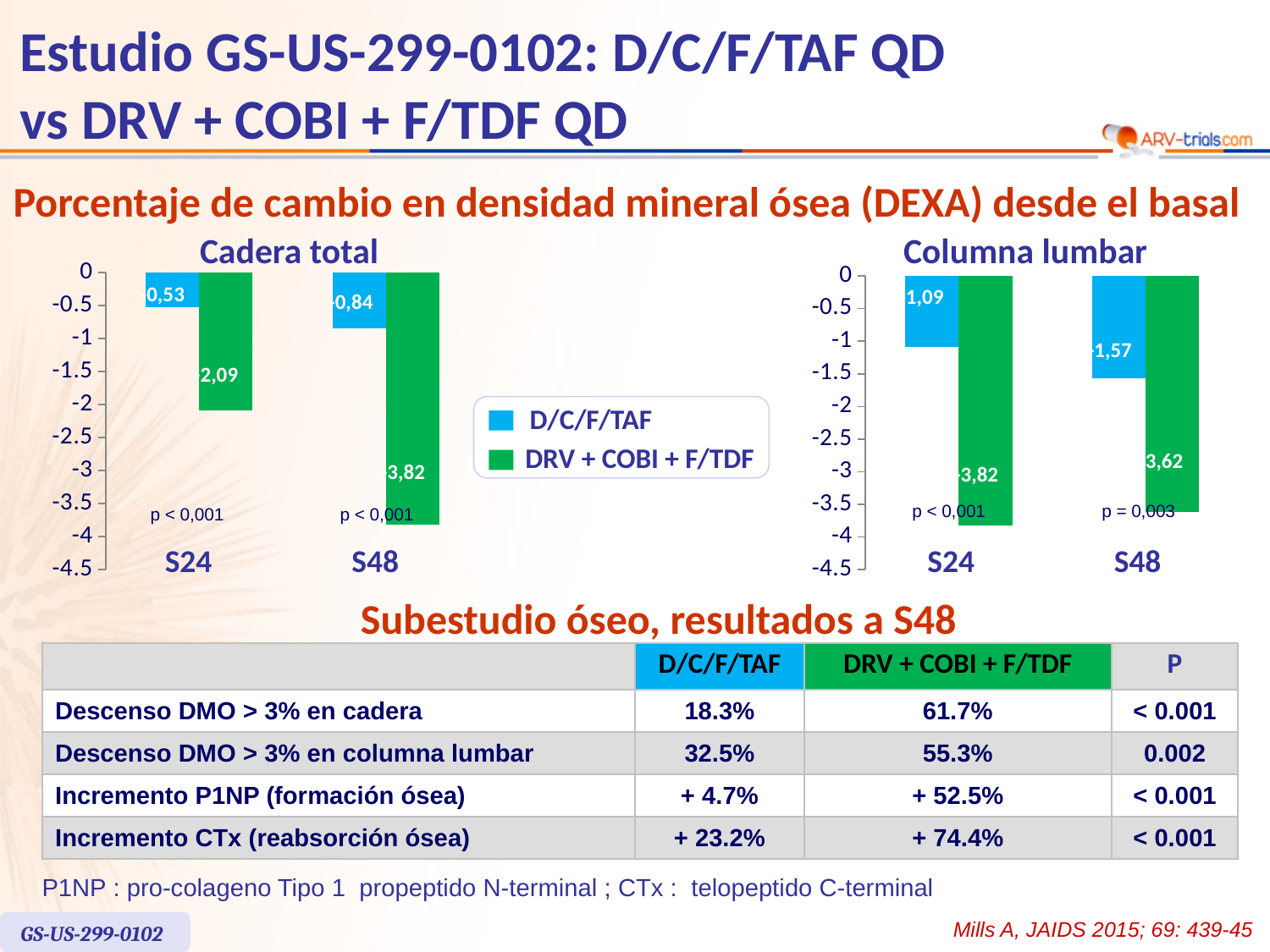
How many series does the legend list for the charts? 2 In the 'Columna lumbar' chart, what is the value for DRV + COBI + F/TDF at S48? -3,62 How many time-point categories are shown on the x axis of the 'Cadera total' chart? 2 In the 'Cadera total' chart, what is the value for D/C/F/TAF at S48? -0,84 In the 'Columna lumbar' chart, what is the value for D/C/F/TAF at S24? -1,09 In the 'Cadera total' chart, what is the difference between the D/C/F/TAF and DRV + COBI + F/TDF values at S48? 2,98 What kind of chart is the 'Cadera total' chart? bar chart In the 'Columna lumbar' chart at S48, which series shows the larger decrease, D/C/F/TAF or DRV + COBI + F/TDF? DRV + COBI + F/TDF In the 'Cadera total' chart, what is the value for DRV + COBI + F/TDF at S24? -2,09 In the 'Cadera total' chart, which bar has the lowest value? DRV + COBI + F/TDF at S48 In the 'Columna lumbar' chart, does the D/C/F/TAF value rise or fall from S24 to S48? fall What colour represents D/C/F/TAF in the legend? blue